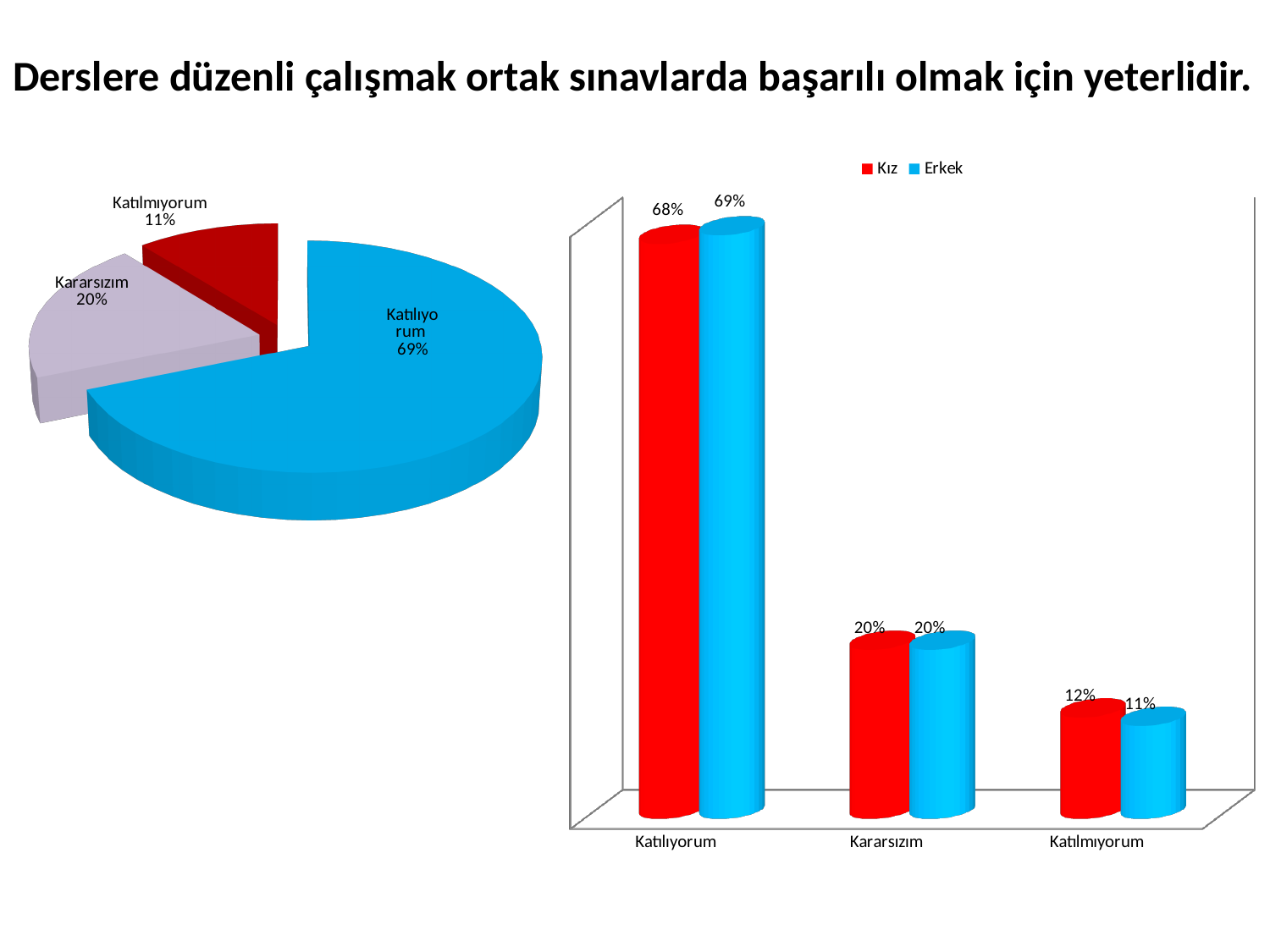
In the bar chart on the right, do the Kız values rise or fall from Katılıyorum to Katılmıyorum? Fall In the pie chart on the left, which category has the smallest slice? Katılmıyorum In the pie chart on the left, what share does Kararsızım have? 20% In the bar chart on the right, which category has the highest value for Erkek? Katılıyorum In the bar chart on the right, what kind of chart is it? Bar chart In the bar chart on the right, how many series does the legend list? 2 In the pie chart on the left, how many slices are there? 3 In the bar chart on the right, what is the value for Erkek in the Katılmıyorum category? 11% In the bar chart on the right, what is the difference between the Kız and Erkek values for Katılıyorum? 1% In the bar chart on the right, which colour represents the Erkek series? Blue In the pie chart on the left, what share does Katılıyorum have? 69% In the bar chart on the right, what is the value for Kız in the Katılıyorum category? 68%